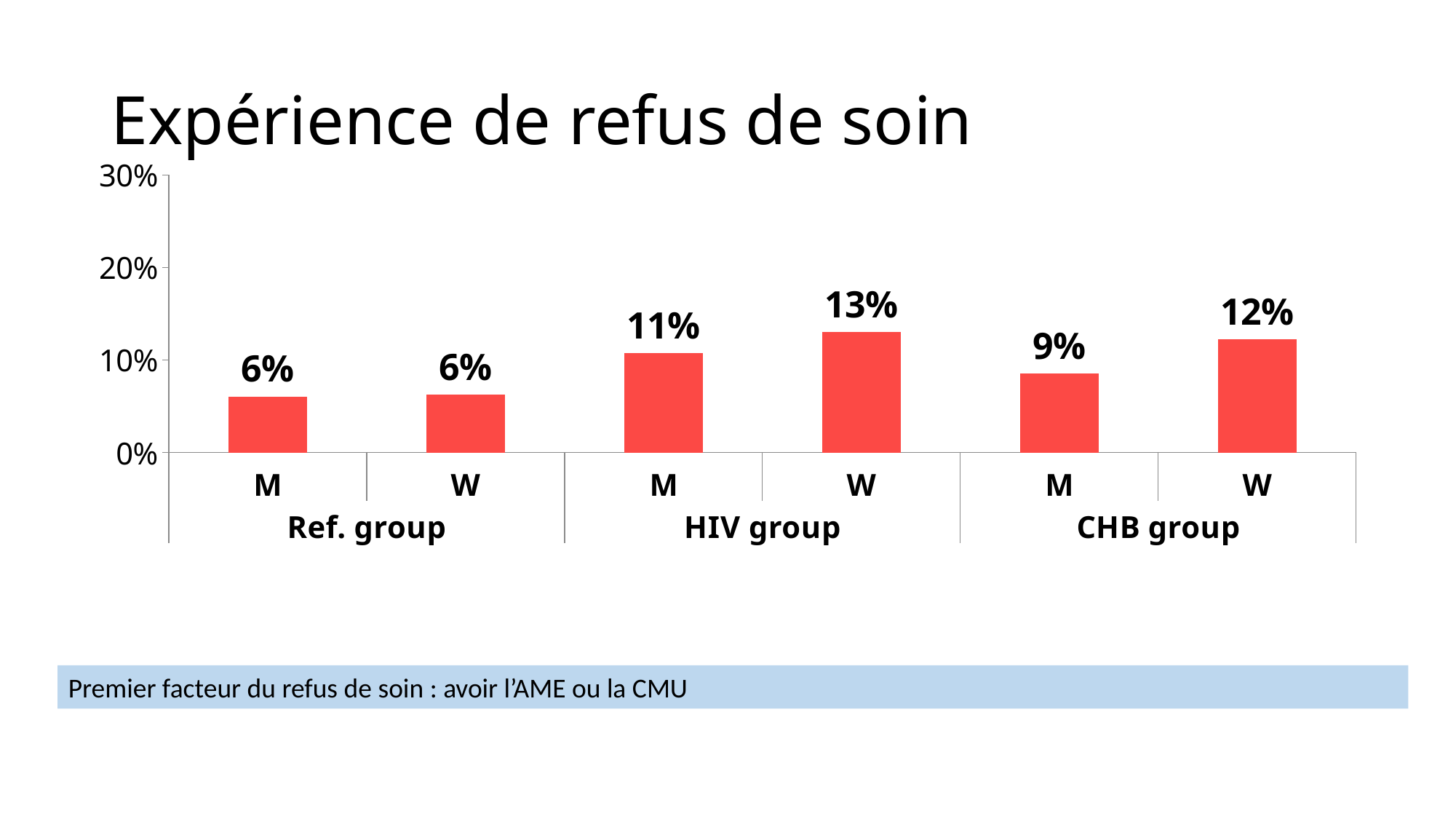
How many groups are shown on the x axis? 3 What is the value for M in the CHB group? 9% What is the difference between W and M in the HIV group? 2% What is the difference between W and M in the CHB group? 3% What kind of chart is shown on the slide? Bar chart Which bar has the highest value? W in the HIV group What is the value for W in the CHB group? 12% How many bars are plotted in the chart? 6 Is the value for W in the CHB group greater or less than 10%? greater What is the value for M in the Ref. group? 6% What is the value for W in the HIV group? 13% Which is larger, M in the HIV group or M in the CHB group? M in the HIV group